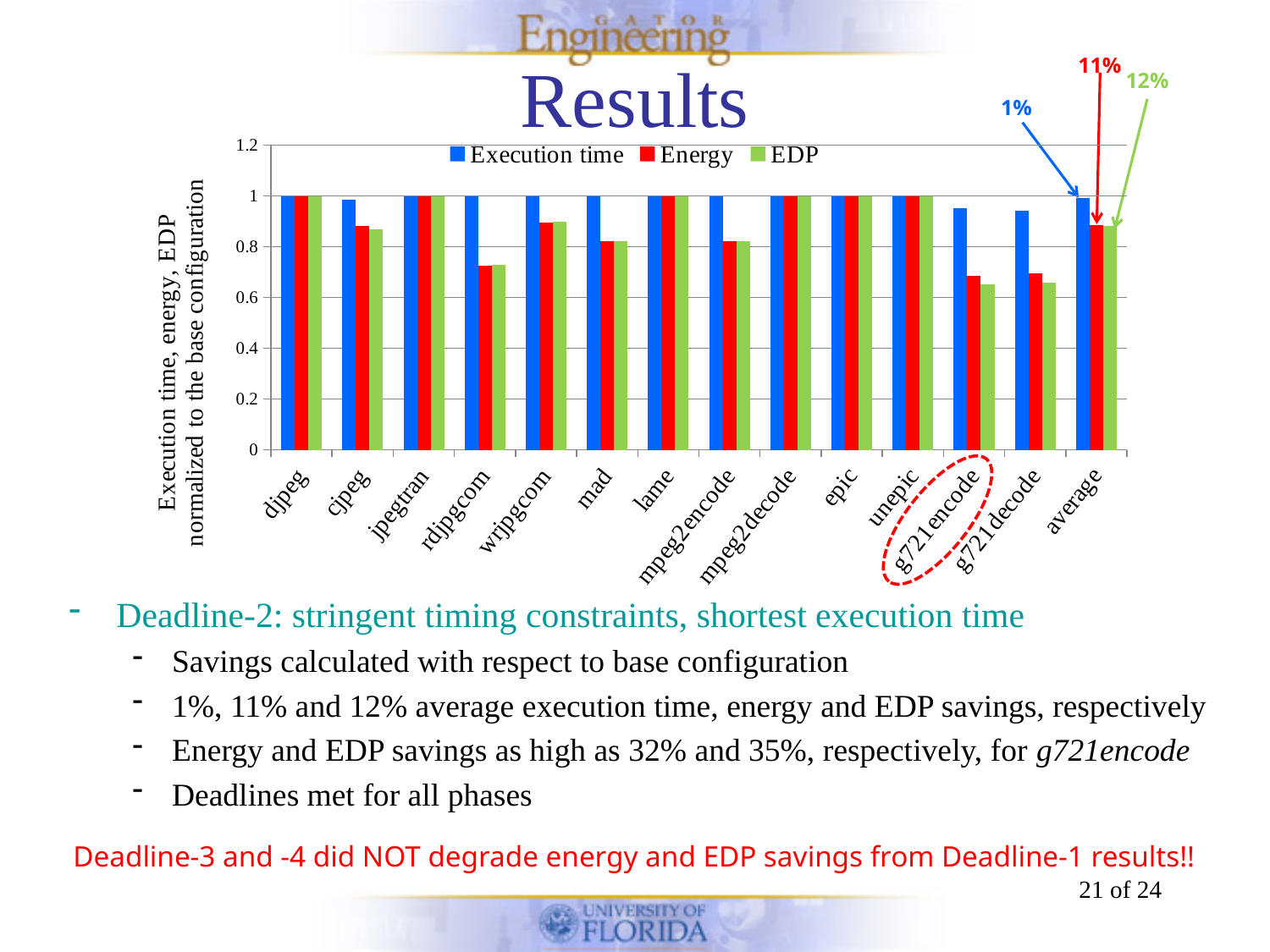
Is the Energy value for g721encode greater or less than 0.8? less Which has the larger Energy value, cjpeg or rdjpgcom? cjpeg What percentage is annotated above the Energy bar for average? 11% Is the Energy value for wrjpgcom greater or less than 0.8? greater Which series are listed in the chart legend? Execution time, Energy, EDP How many categories are shown along the x axis of the chart? 14 What is the Energy value for jpegtran? 1 Is the EDP value for rdjpgcom greater or less than 0.8? less What kind of chart is shown on the slide? bar chart How many series does the chart legend list? 3 What is the Execution time value for djpeg? 1